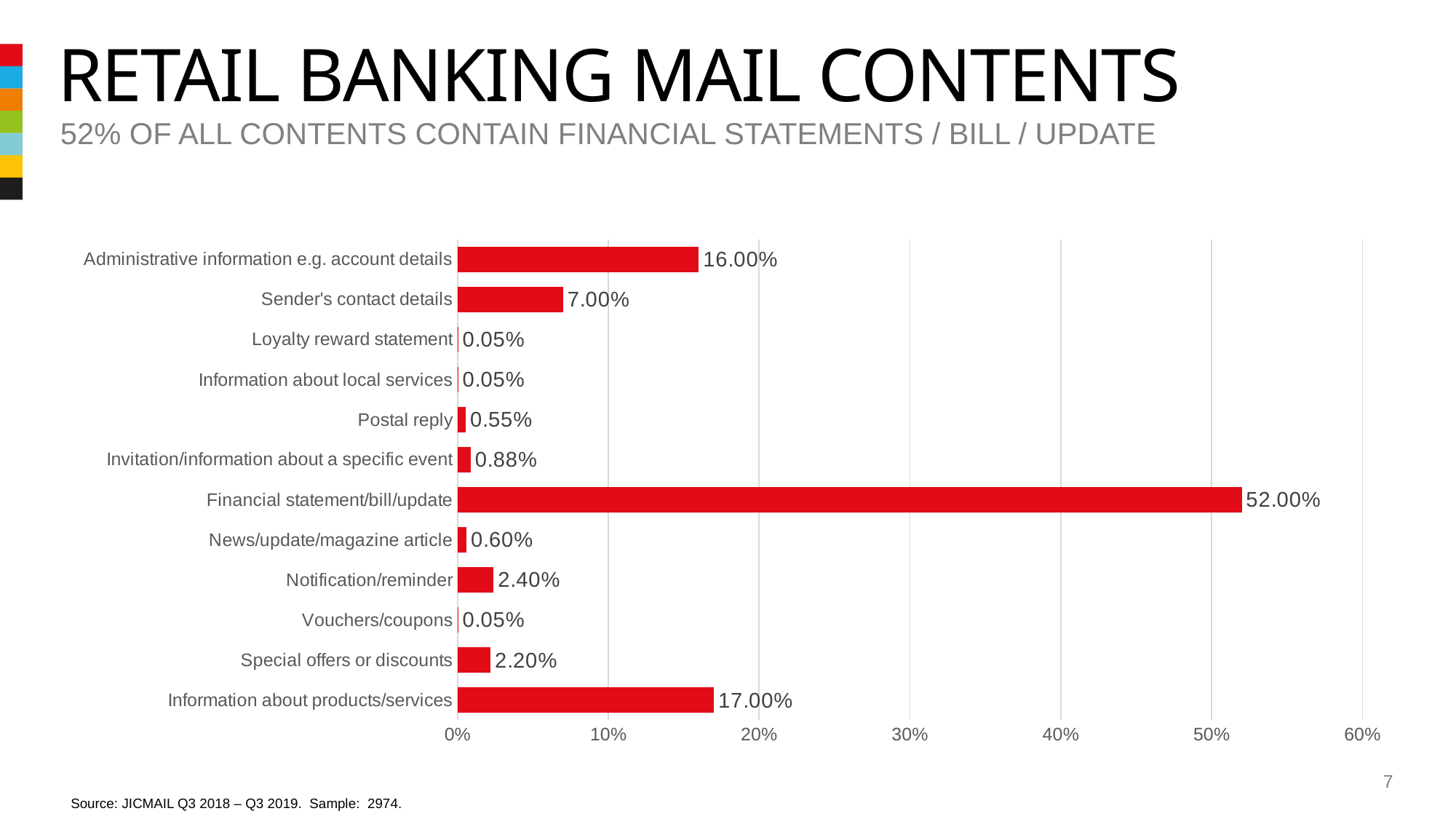
What is the difference between Financial statement/bill/update and Sender's contact details? 45.00% Which category has the highest value? Financial statement/bill/update What kind of chart is shown on the slide? Bar chart What is the value for Financial statement/bill/update? 52.00% How many categories are shown in the chart? 12 What is the difference between Information about products/services and Administrative information e.g. account details? 1.00% What is the value for Notification/reminder? 2.40% What is the value for Administrative information e.g. account details? 16.00% Which is larger, Postal reply or News/update/magazine article? News/update/magazine article Which is larger, Special offers or discounts or Notification/reminder? Notification/reminder Is the value for Financial statement/bill/update greater or less than 50%? greater What is the value for Invitation/information about a specific event? 0.88%